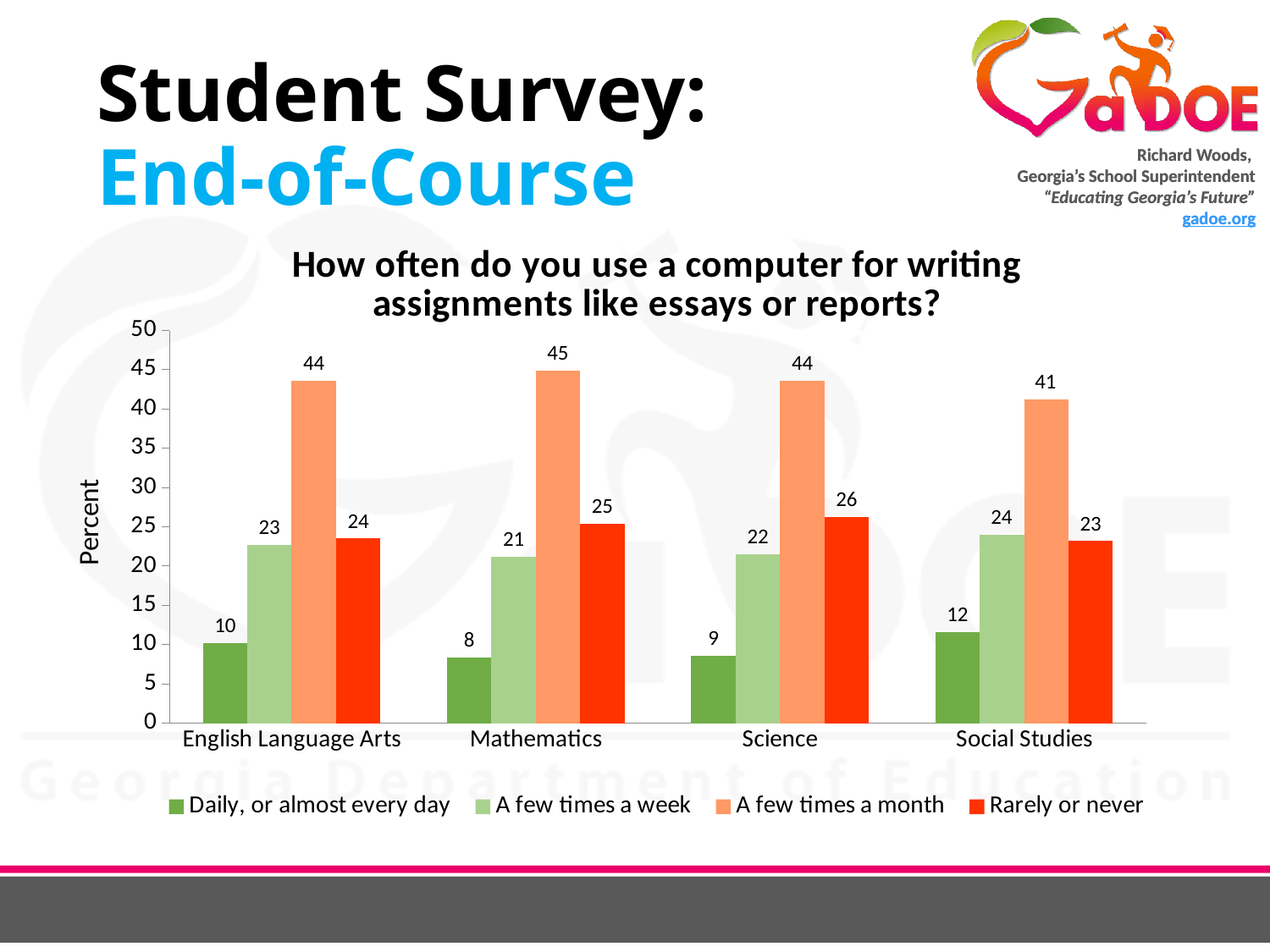
Which is larger in Social Studies: "A few times a week" or "Rarely or never"? A few times a week What is the value for "A few times a month" in Mathematics? 45 How many series does the legend list? 4 What is the difference between "A few times a month" and "Rarely or never" in English Language Arts? 20 What is the value for "Daily, or almost every day" in Social Studies? 12 How many subject categories are shown on the x axis? 4 Which subject has the highest value for "A few times a month"? Mathematics What is the title of the chart? How often do you use a computer for writing assignments like essays or reports? Which subject has the lowest value for "Daily, or almost every day"? Mathematics What kind of chart is shown? Bar chart What is the label on the vertical axis? Percent What is the value for "Rarely or never" in Science? 26